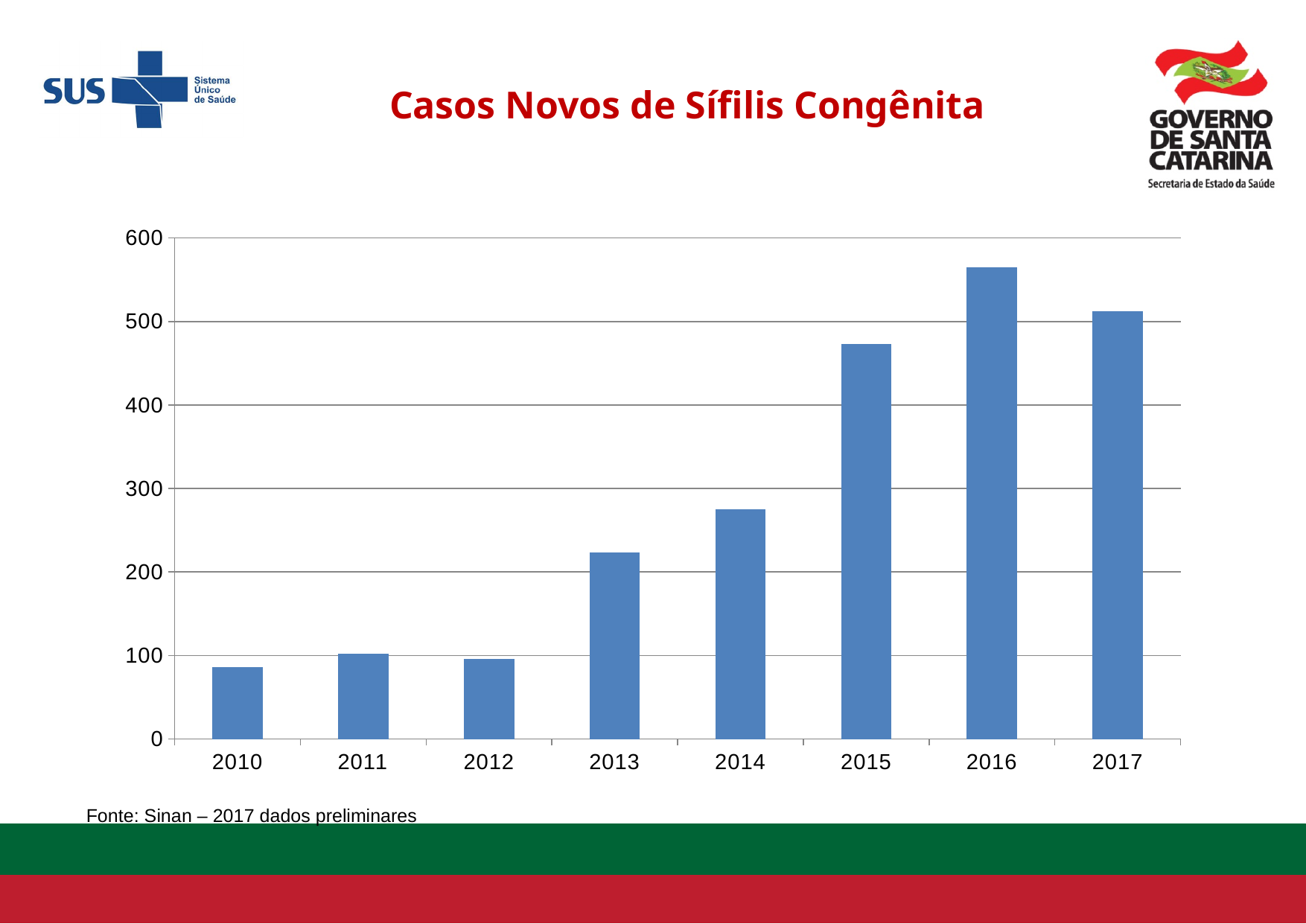
Do the values generally rise or fall from 2010 to 2016? rise Which year has the larger value, 2016 or 2017? 2016 Which year has the larger value, 2014 or 2015? 2015 Is the value for 2014 greater or less than 300? less Is the value for 2016 greater or less than 500? greater Which year has the highest number of new cases? 2016 What kind of chart is shown on the slide? bar chart Is the value for 2015 greater or less than 500? less How many years are shown on the x axis of the chart? 8 What is the title of the chart? Casos Novos de Sífilis Congênita